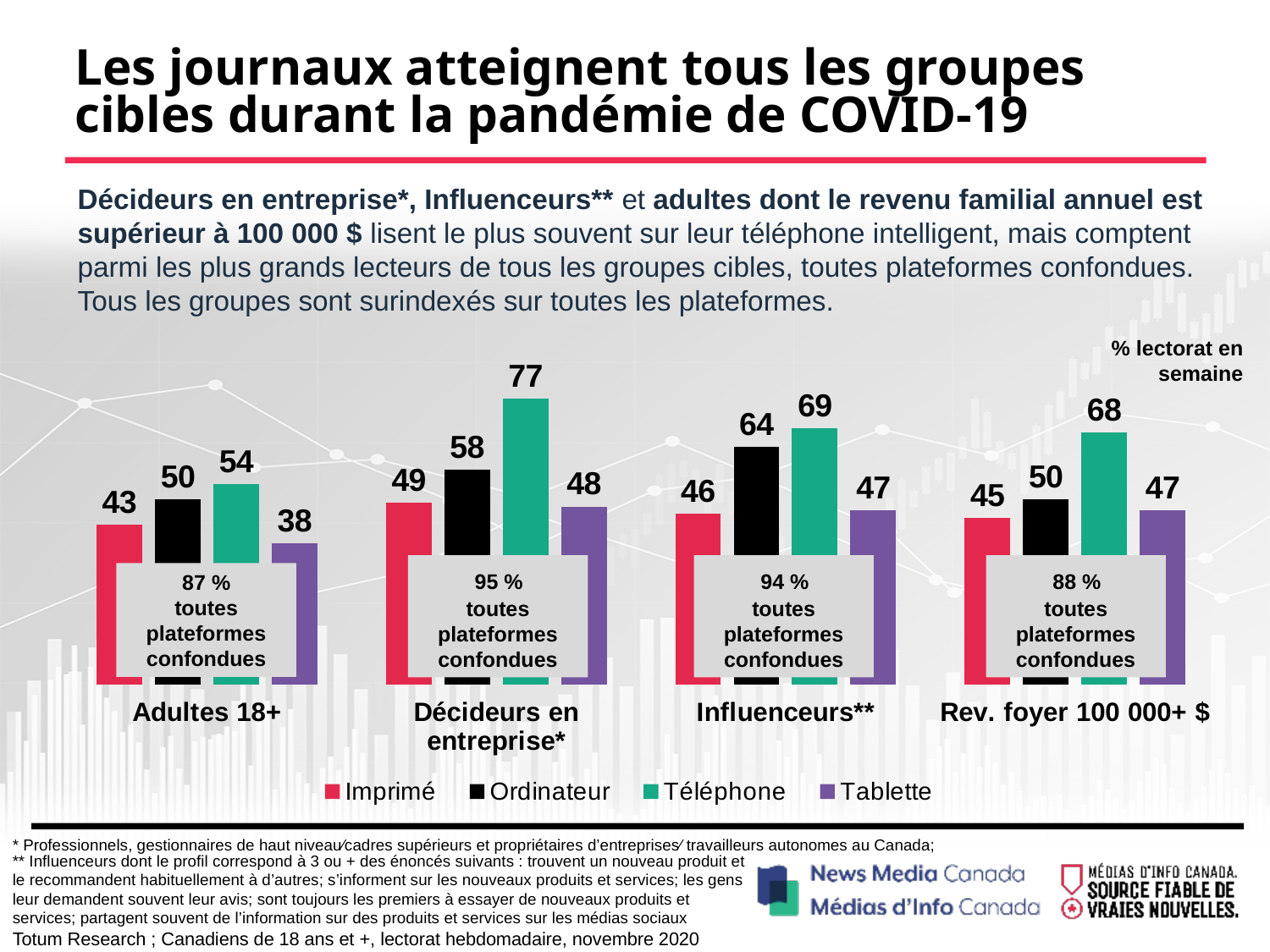
How many series does the legend list? 4 What is the difference between the Téléphone and Imprimé values for Influenceurs**? 23 How many categories are shown on the x axis of the chart? 4 What kind of chart is shown on the slide? Bar chart What is the Imprimé value for Rev. foyer 100 000+ $? 45 Which category has the highest Téléphone value? Décideurs en entreprise* What is the Téléphone value for Décideurs en entreprise*? 77 What is the Tablette value for Adultes 18+? 38 Which category has the lowest Tablette value? Adultes 18+ What percentage is shown for 'toutes plateformes confondues' for Décideurs en entreprise*? 95 % Which is larger for Rev. foyer 100 000+ $: the Ordinateur value or the Téléphone value? Téléphone What is the Ordinateur value for Influenceurs**? 64